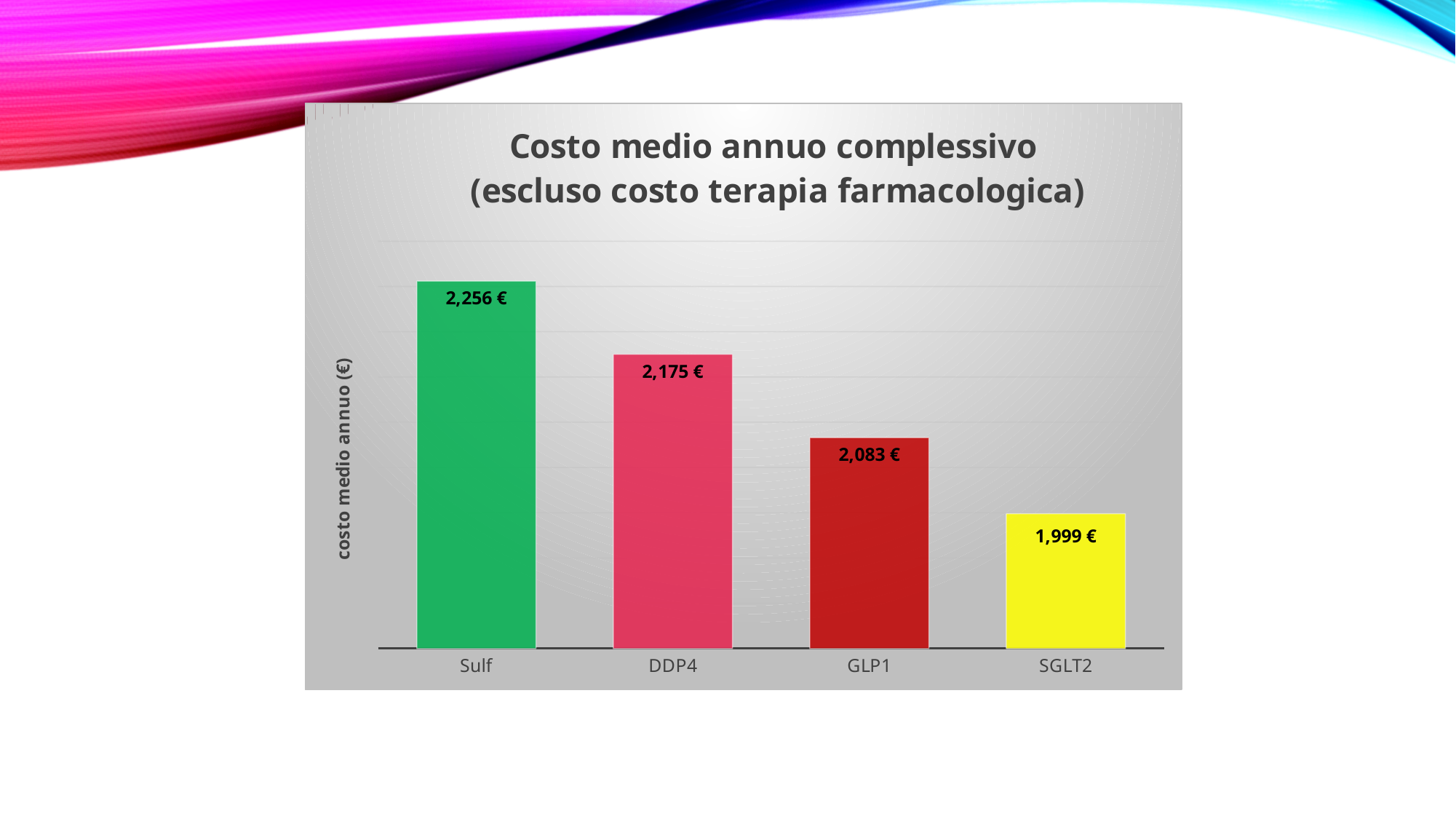
Which category has the highest value? Sulf Which is larger, the value for DDP4 or the value for GLP1? DDP4 What is the difference between the values for Sulf and SGLT2? 257 € What is the difference between the values for DDP4 and GLP1? 92 € What is the value for SGLT2? 1,999 € What is the value for DDP4? 2,175 € How many categories are shown on the x axis? 4 What kind of chart is this? Bar chart What is the value for GLP1? 2,083 € Which category has the lowest value? SGLT2 What is the value for Sulf? 2,256 € Do the values rise or fall from left to right along the x axis? Fall